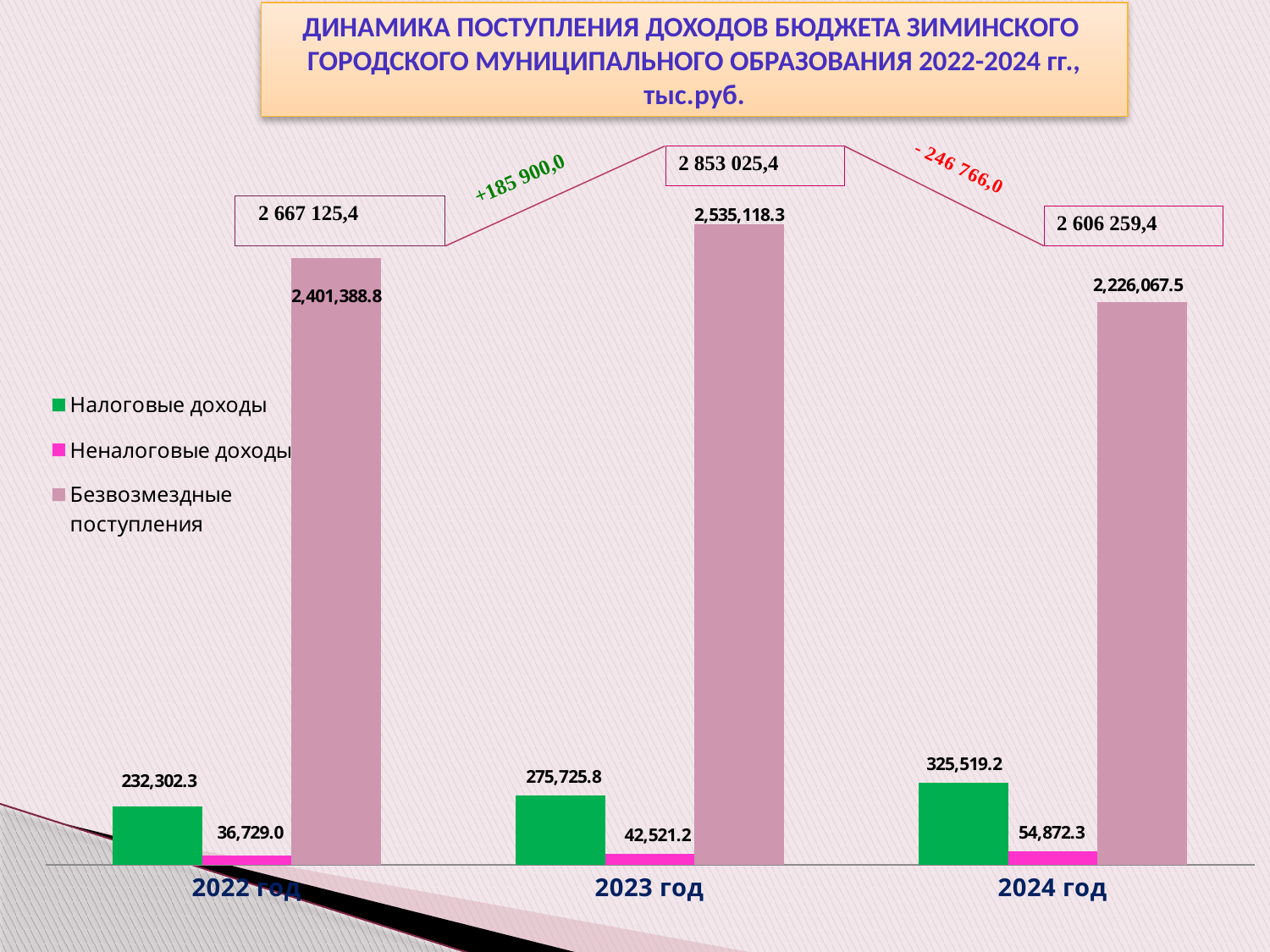
What is the value of Неналоговые доходы for 2022 год? 36,729.0 What total budget income is shown in the box above 2023 год? 2 853 025,4 In which year is Безвозмездные поступления highest? 2023 год In which year is Налоговые доходы lowest? 2022 год How many series does the legend list? 3 What is the value of Налоговые доходы for 2023 год? 275,725.8 Do the values of Налоговые доходы rise or fall from 2022 год to 2024 год? rise What type of chart is shown on the slide? bar chart What is the value of Безвозмездные поступления for 2024 год? 2,226,067.5 What is the difference between Налоговые доходы in 2024 год and 2023 год? 49,793.4 Which is larger: Неналоговые доходы in 2023 год or in 2024 год? 2024 год How many year categories are shown on the x axis? 3